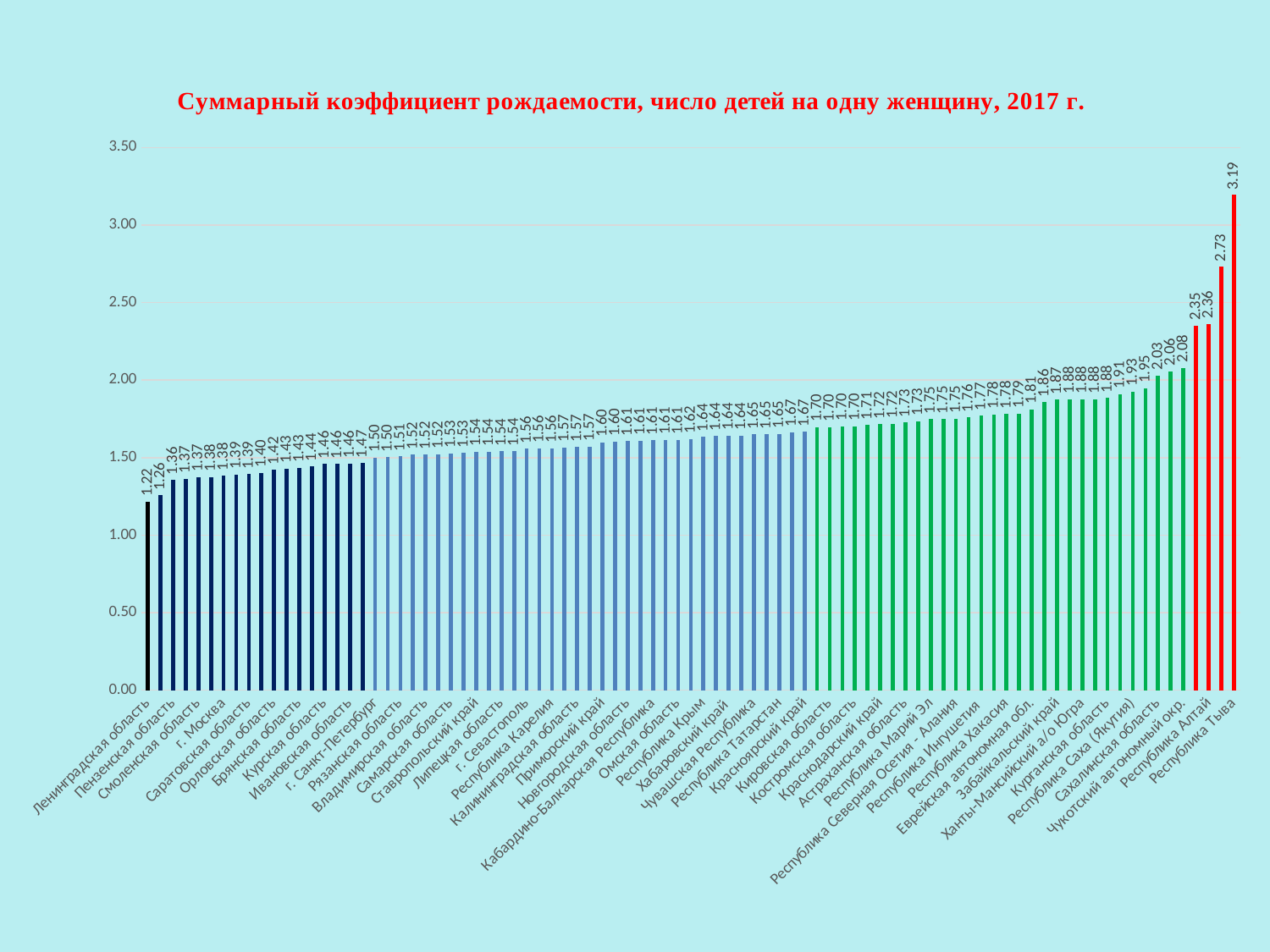
What kind of chart is shown on the slide? bar chart What is the difference between the two highest bars, 3.19 and 2.73? 0.46 Is the value for Ленинградская область greater or less than 1.50? less Do the bar values rise or fall from left to right along the x axis? rise Which region has the highest total fertility rate on the chart? Республика Тыва What is the difference between the highest value (3.19) and the lowest value (1.22) on the chart? 1.97 Which region has the lowest total fertility rate on the chart? Ленинградская область What is the title of the chart? Суммарный коэффициент рождаемости, число детей на одну женщину, 2017 г. What is the value of the lowest bar on the chart? 1.22 What is the value of the highest bar on the chart? 3.19 What is the value of the second-highest bar on the chart? 2.73 Is the value for Республика Тыва greater or less than 3.00? greater